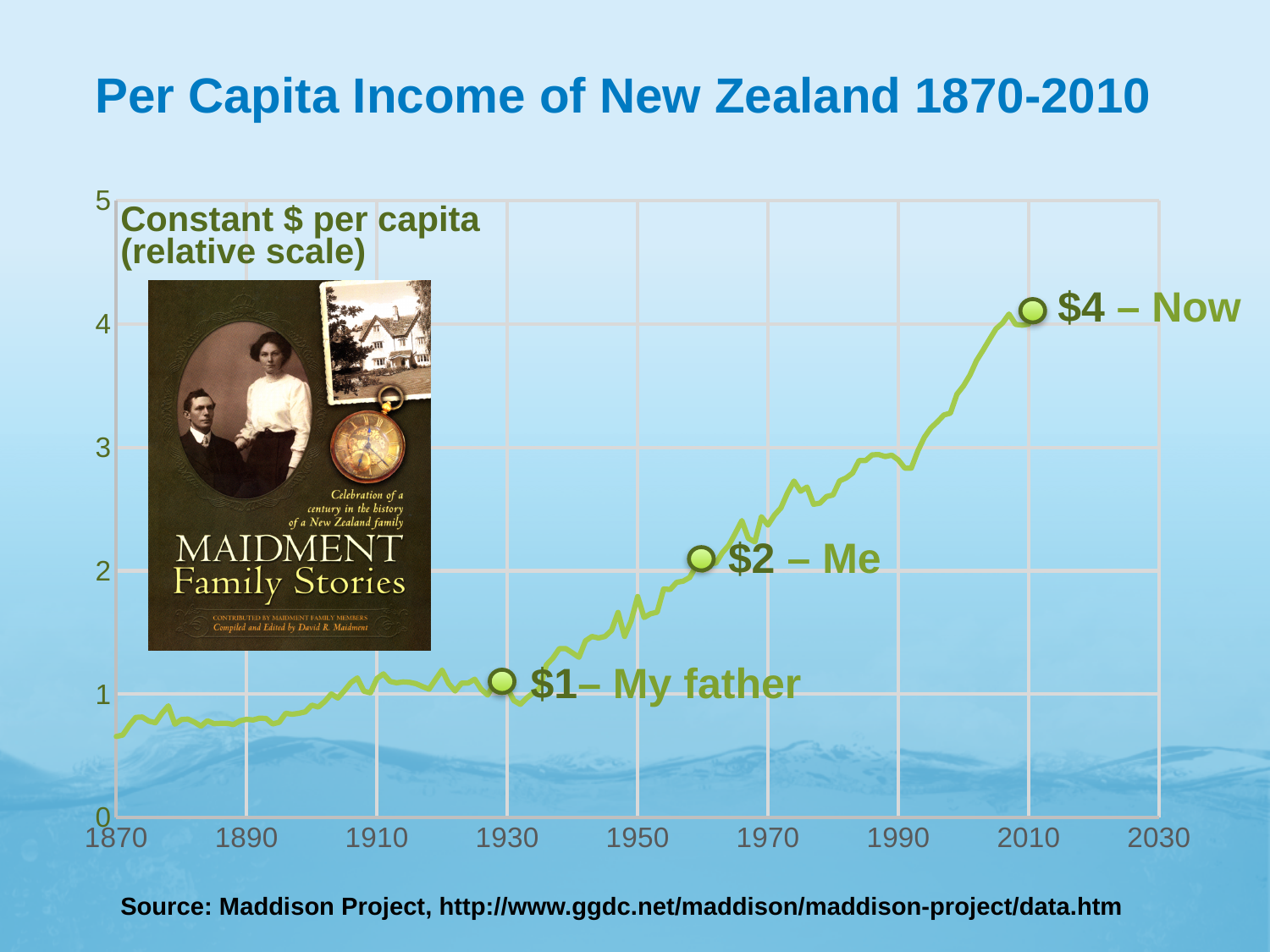
What is the difference between the value labelled "Now" and the value labelled "Me"? $2 Is the value for 1970 greater or less than 2? greater What value is labelled at the point marked "Now"? $4 What kind of chart is shown on the slide? line chart What value is labelled at the point marked "Me"? $2 What is the title of the chart? Per Capita Income of New Zealand 1870-2010 Which labelled point has the higher value, "Me" or "My father"? Me What is the difference between the value labelled "Now" and the value labelled "My father"? $3 Is the value for 1870 greater or less than 1? less What value is labelled at the point marked "My father"? $1 Which of the three labelled points has the highest value? $4 – Now Overall, does per capita income rise or fall from 1870 to 2010? rise